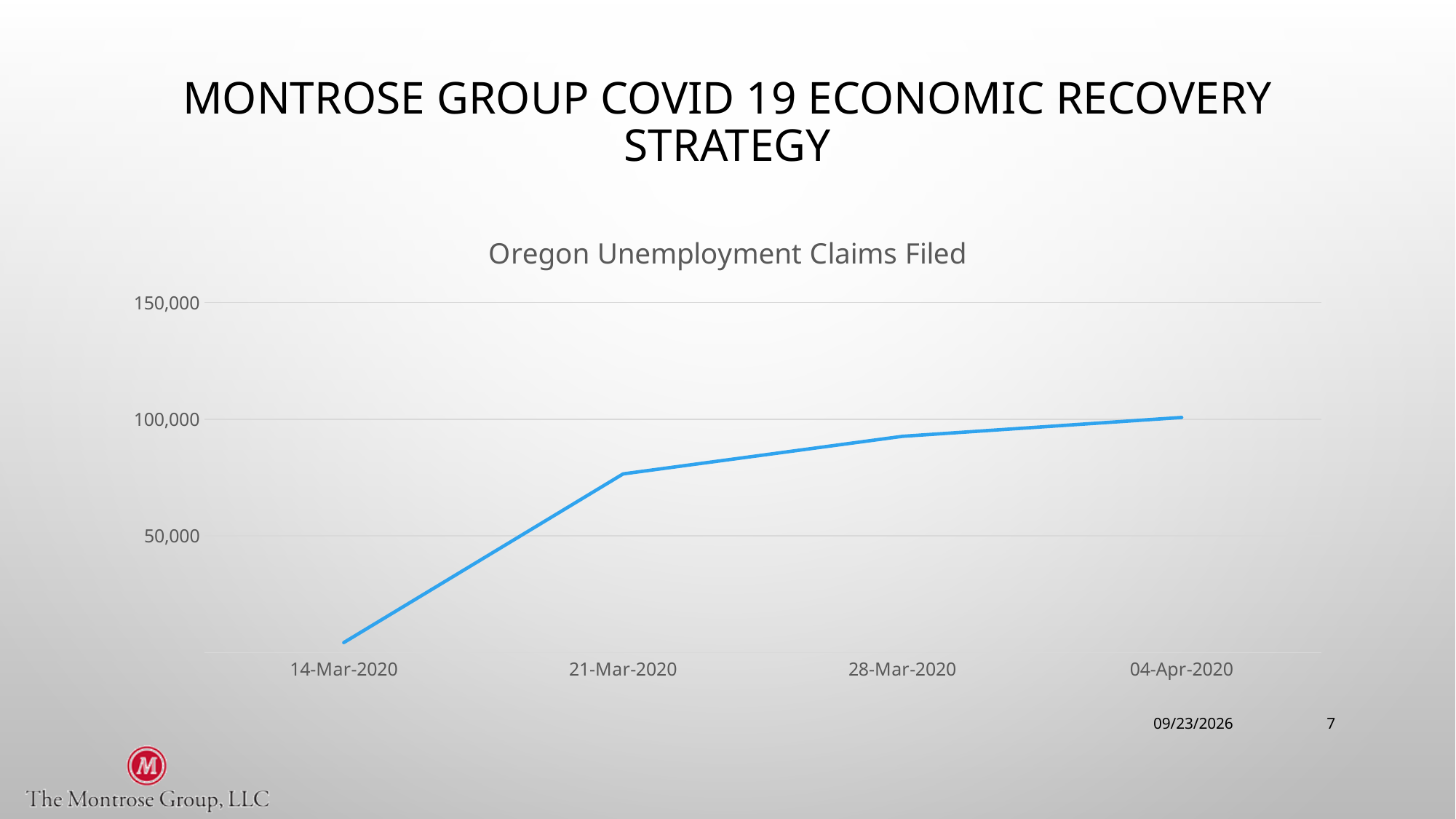
Is the value for 04-Apr-2020 greater or less than 150,000? less Which date has more claims filed, 14-Mar-2020 or 21-Mar-2020? 21-Mar-2020 How many dates are plotted on the x axis of the chart? 4 What type of chart is shown on the slide? Line chart Which date has more claims filed, 21-Mar-2020 or 28-Mar-2020? 28-Mar-2020 Do the Oregon unemployment claims filed rise or fall from 14-Mar-2020 to 04-Apr-2020? Rise Is the value for 21-Mar-2020 greater or less than 50,000? greater Is the value for 14-Mar-2020 greater or less than 50,000? less Which date has the highest number of Oregon unemployment claims filed? 04-Apr-2020 What is the title of the chart? Oregon Unemployment Claims Filed Which date has the lowest number of Oregon unemployment claims filed? 14-Mar-2020